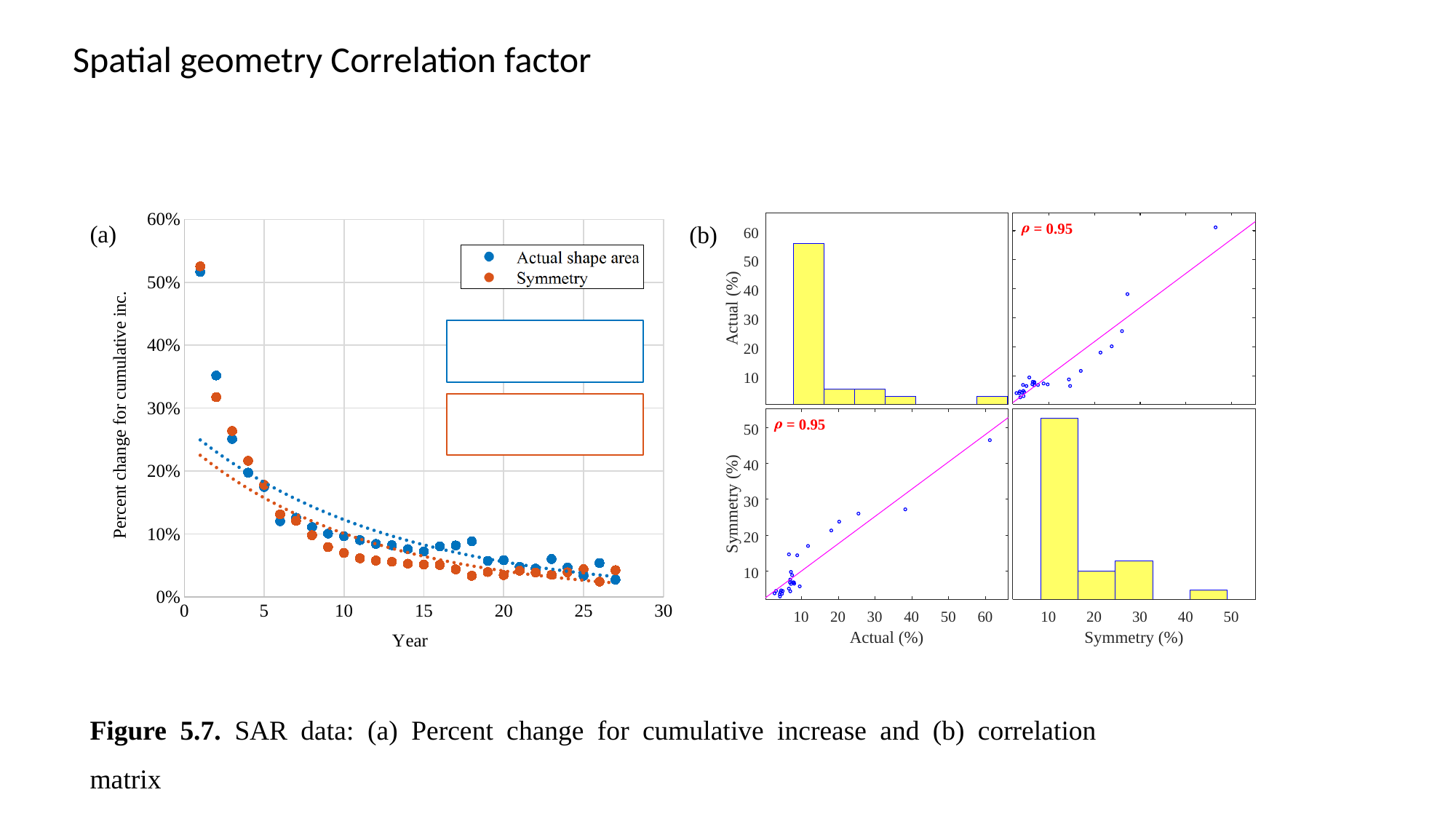
How many series does the legend of chart (a) list? 2 In chart (a), is the value for Symmetry at year 2 greater or less than 30%? greater What is the label of the x axis in chart (a)? Year What are the two series named in the legend of chart (a)? Actual shape area and Symmetry In chart (a), is the value for Actual shape area at year 1 greater or less than 50%? greater What kind of chart is chart (a)? scatter plot In chart (a), which series has the larger value at year 10, Actual shape area or Symmetry? Actual shape area In chart (a), which series has the larger value at year 2, Actual shape area or Symmetry? Actual shape area In chart (a), is the value for Actual shape area at year 27 greater or less than 10%? less In chart (b), which bin of the Actual (%) histogram has the highest count? the first bin (around 10) In chart (b), what correlation coefficient ρ is printed on the scatter panels? 0.95 In chart (a), do the values for Actual shape area rise or fall as Year increases? fall